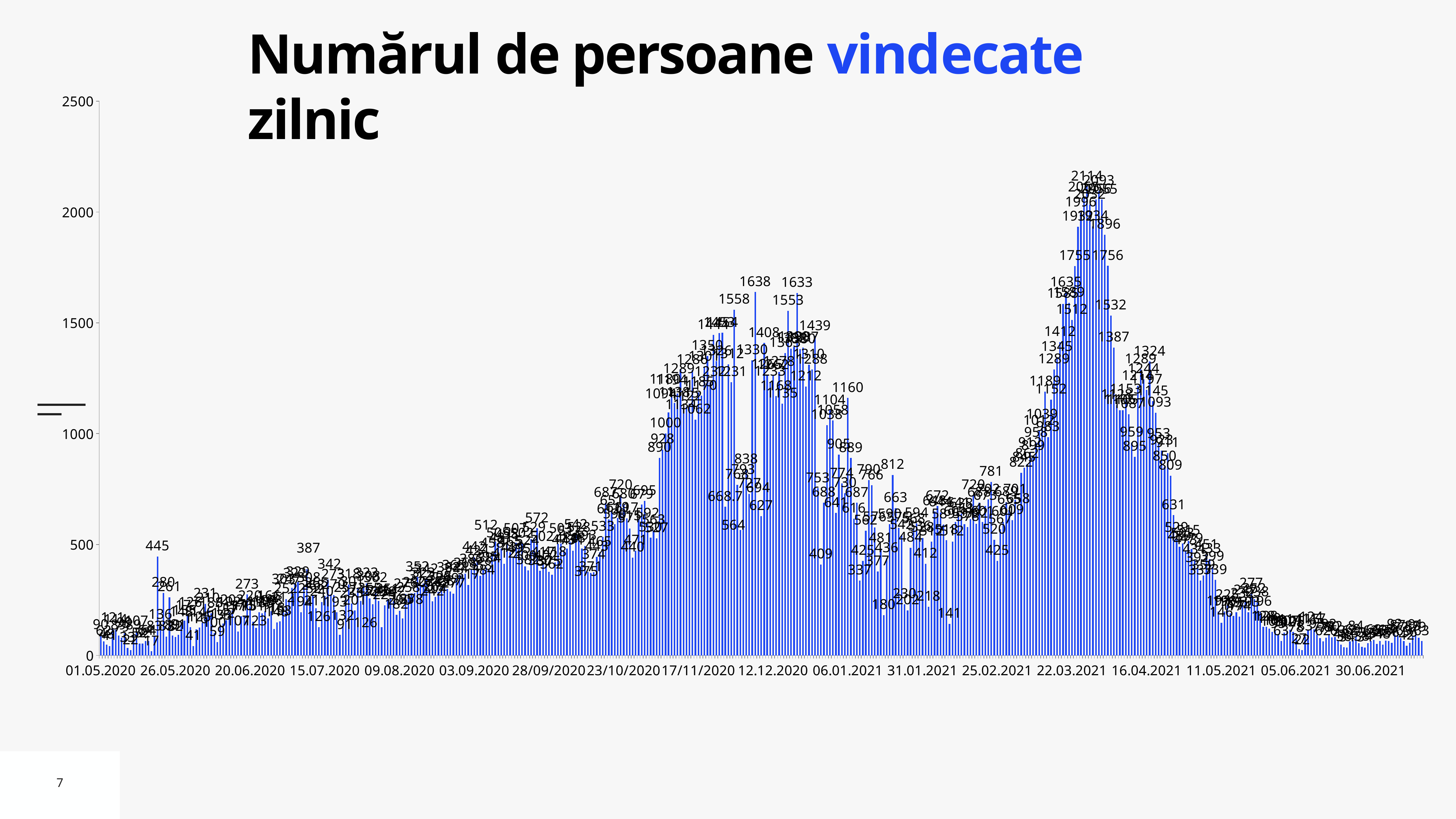
Is the value for 01.05.2020 greater or less than 500? less Do the values generally rise or fall between 01.05.2020 and 17/11/2020? rise Are the values around 30.06.2021 greater or less than 500? less Do the values generally rise or fall between 22.03.2021 and 30.06.2021? fall Which is larger: the peak around 22.03.2021 or the peak around 12.12.2020? the peak around 22.03.2021 What is the highest value labelled on the chart? 2114 What is the highest tick value shown on the vertical axis? 2500 Is the peak value reached around 22.03.2021 greater or less than 2000? greater What kind of chart is shown on the slide? bar chart What is the title of the chart? Numărul de persoane vindecate zilnic What is the first date label on the horizontal axis? 01.05.2020